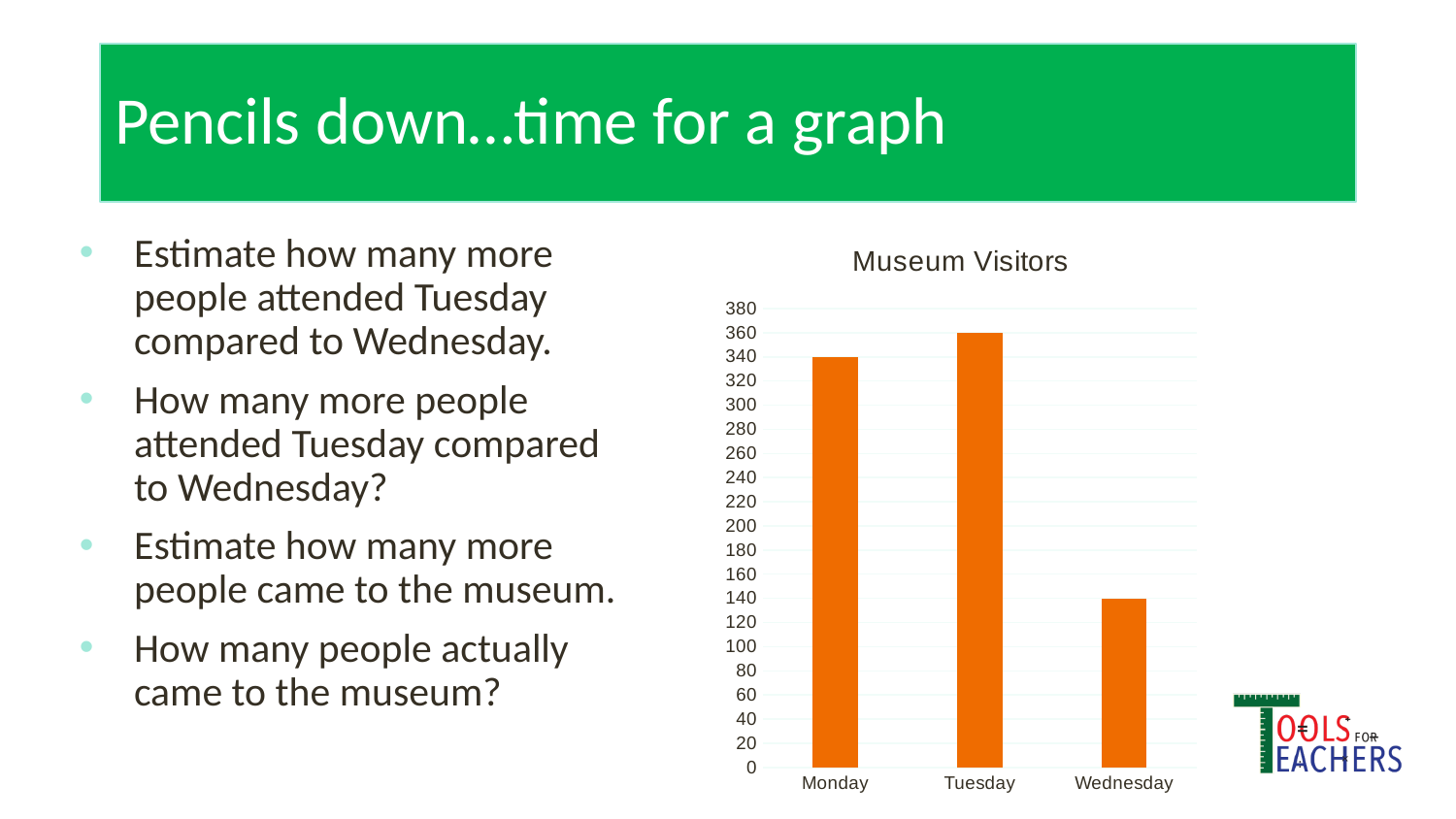
How many museum visitors are shown for Tuesday? 360 How many museum visitors are shown for Wednesday? 140 Which day has the highest number of museum visitors? Tuesday How many more museum visitors were there on Tuesday than on Wednesday? 220 Is the value for Monday greater or less than 300? greater What is the title of the chart? Museum Visitors Which day had more museum visitors, Monday or Wednesday? Monday What type of chart is shown on the slide? bar chart How many categories are shown on the x axis of the chart? 3 Is the value for Wednesday greater or less than 200? less How many museum visitors are shown for Monday? 340 Which day has the lowest number of museum visitors? Wednesday